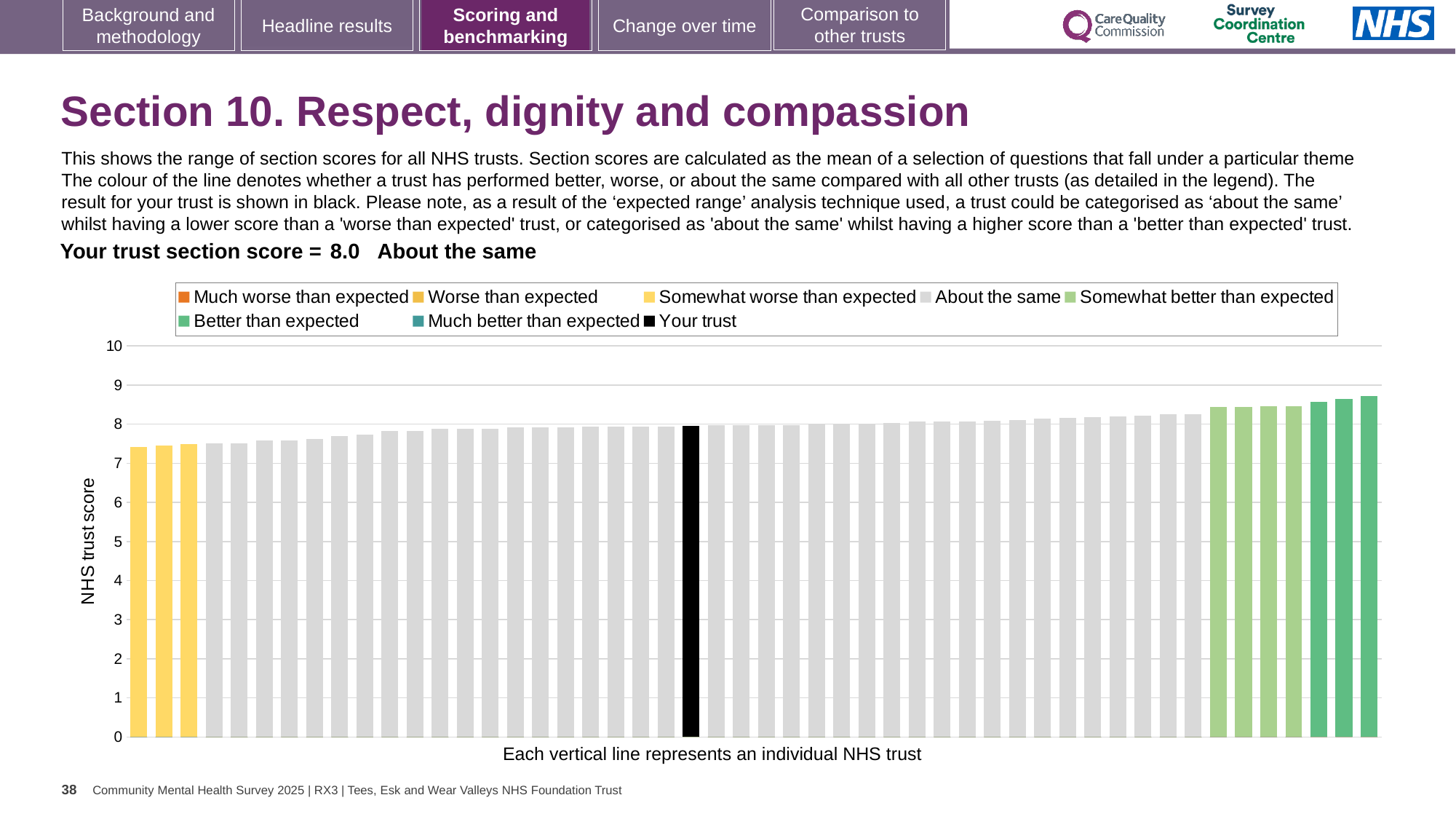
Is the value of the black 'Your trust' bar greater or less than 9? less Do the bar values rise or fall moving from left to right along the x axis? rise What colour is the bar representing your trust? black Is the value of the tallest bar on the chart greater or less than 8? greater What is the section score for your trust shown on the slide? 8.0 Which category is your trust placed in for this section? About the same How many bars on the chart are coloured yellow? 3 What is the title of the vertical axis? NHS trust score Is the value of the black 'Your trust' bar greater or less than 7? greater What kind of chart is shown on the slide? bar chart How many entries does the chart legend list? 8